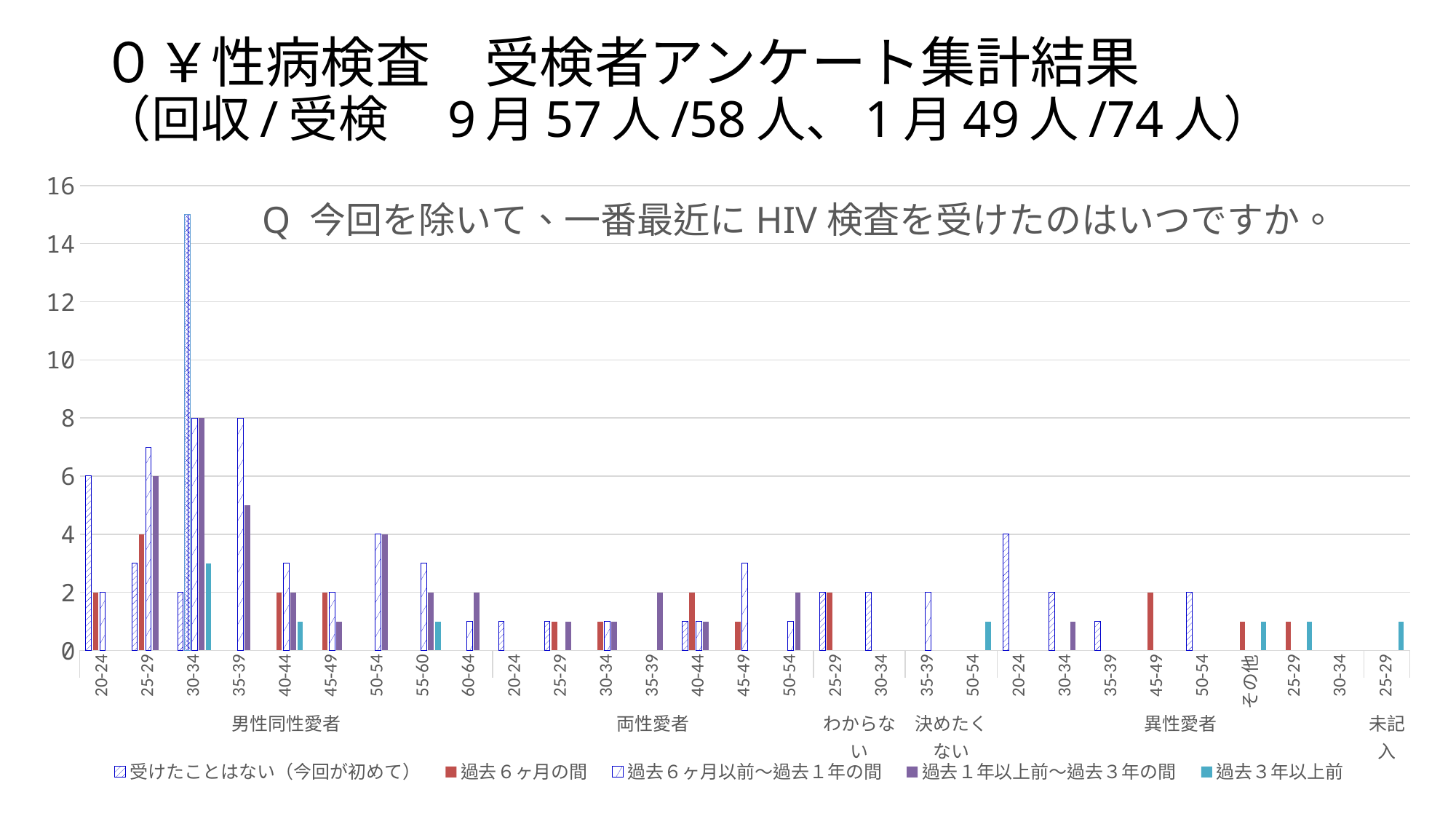
How many series does the legend list? 5 Which age group under 男性同性愛者 has the tallest 受けたことはない（今回が初めて） bar? 20-24 Is the value of 受けたことはない（今回が初めて） for the 30-34 age group under 男性同性愛者 greater or less than 14? less What is the value of 過去１年以上前～過去３年の間 for the 30-34 age group under 男性同性愛者? 8 How many top-level groups (sexual orientation categories) are shown along the x axis? 6 What is the value of 受けたことはない（今回が初めて） for the 20-24 age group under 異性愛者? 4 What colour represents the 過去６ヶ月の間 series in the legend? red What kind of chart is shown on the slide? bar chart What is the value of 過去６ヶ月以前～過去１年の間 for the 20-24 age group under 男性同性愛者? 2